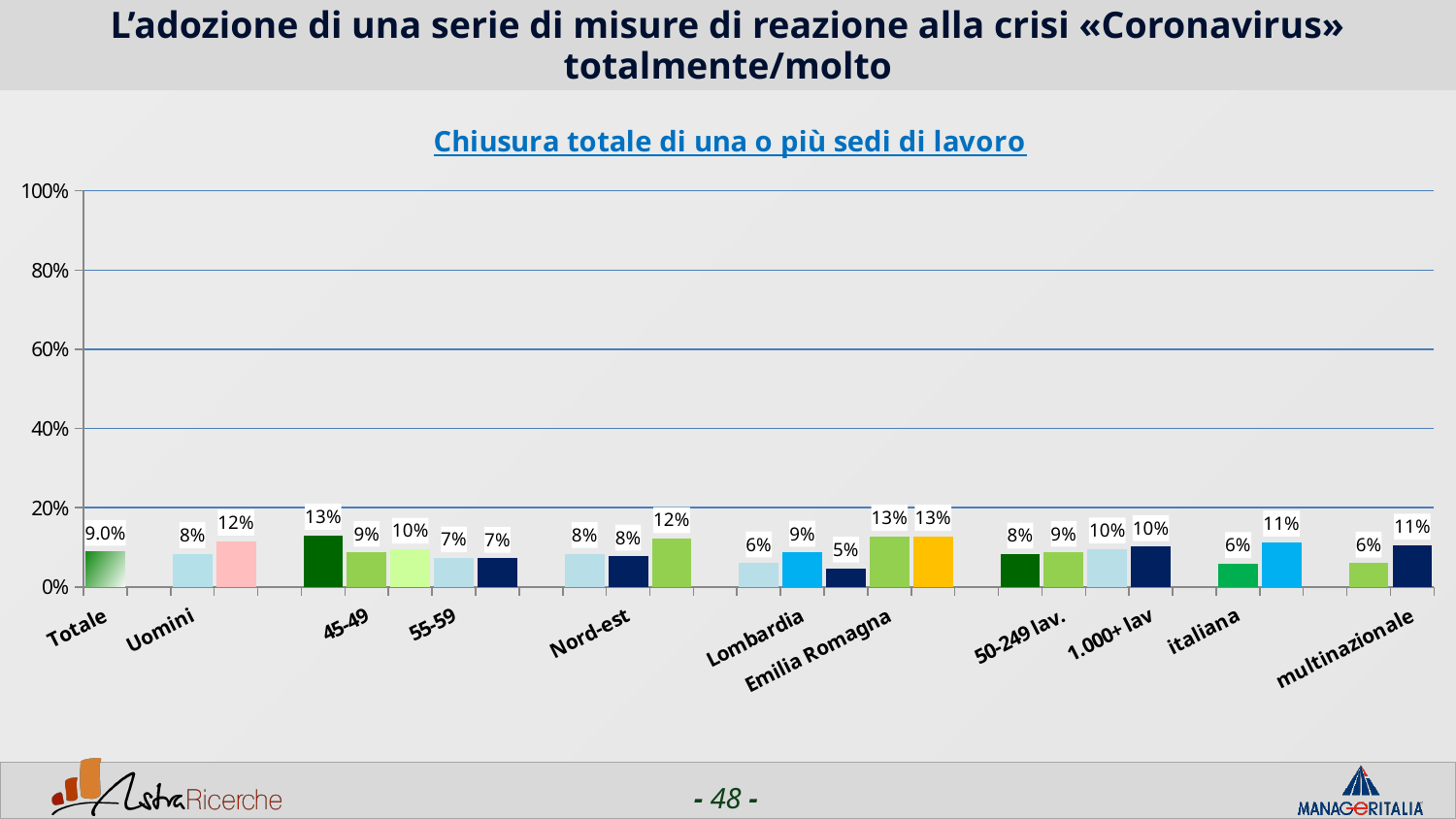
What is the value for the 55-59 category? 7% Which is larger, the value for Emilia Romagna or the value for Lombardia? Emilia Romagna What is the value for the 45-49 category? 9% What kind of chart is shown on the slide? bar chart What is the value for Emilia Romagna? 13% Is the value for Nord-est greater or less than 20%? less What is the value for multinazionale? 11% What is the value for 1.000+ lav? 10% What is the value for Lombardia? 9% What is the difference between the values for 45-49 and 55-59? 2 percentage points What is the value for Totale? 9.0% What is the value for Uomini? 8%